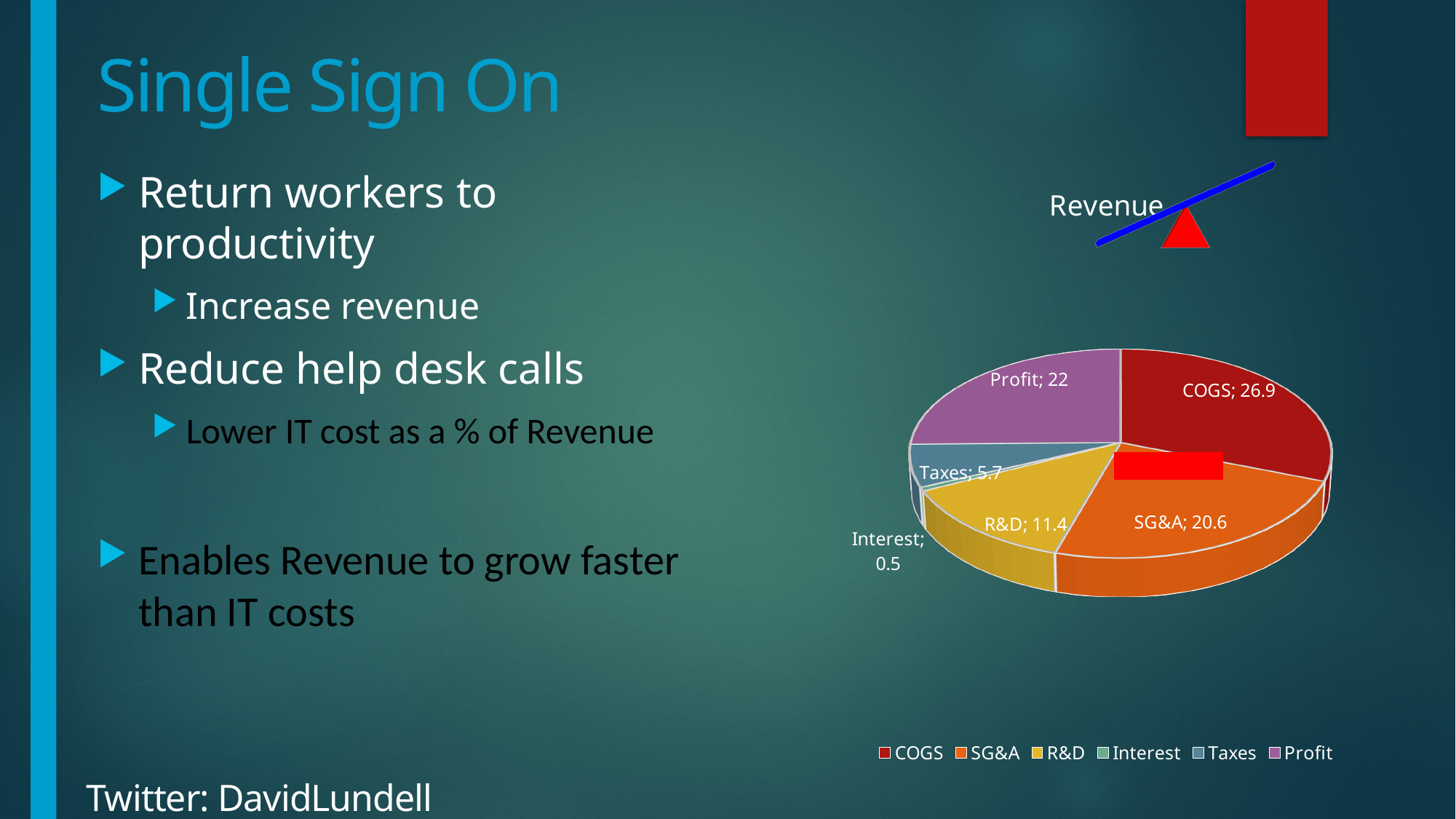
Which category has the smallest slice in the pie chart? Interest What type of chart is shown on the slide? Pie chart What is the value for SG&A in the pie chart? 20.6 What is the value for Interest in the pie chart? 0.5 What is the difference between the COGS value and the Profit value in the pie chart? 4.9 How many categories does the legend of the pie chart list? 6 Which is larger in the pie chart, SG&A or R&D? SG&A What is the value for Taxes in the pie chart? 5.7 What is the value for COGS in the pie chart? 26.9 What is the value for R&D in the pie chart? 11.4 What is the value for Profit in the pie chart? 22 Which category has the largest slice in the pie chart? COGS